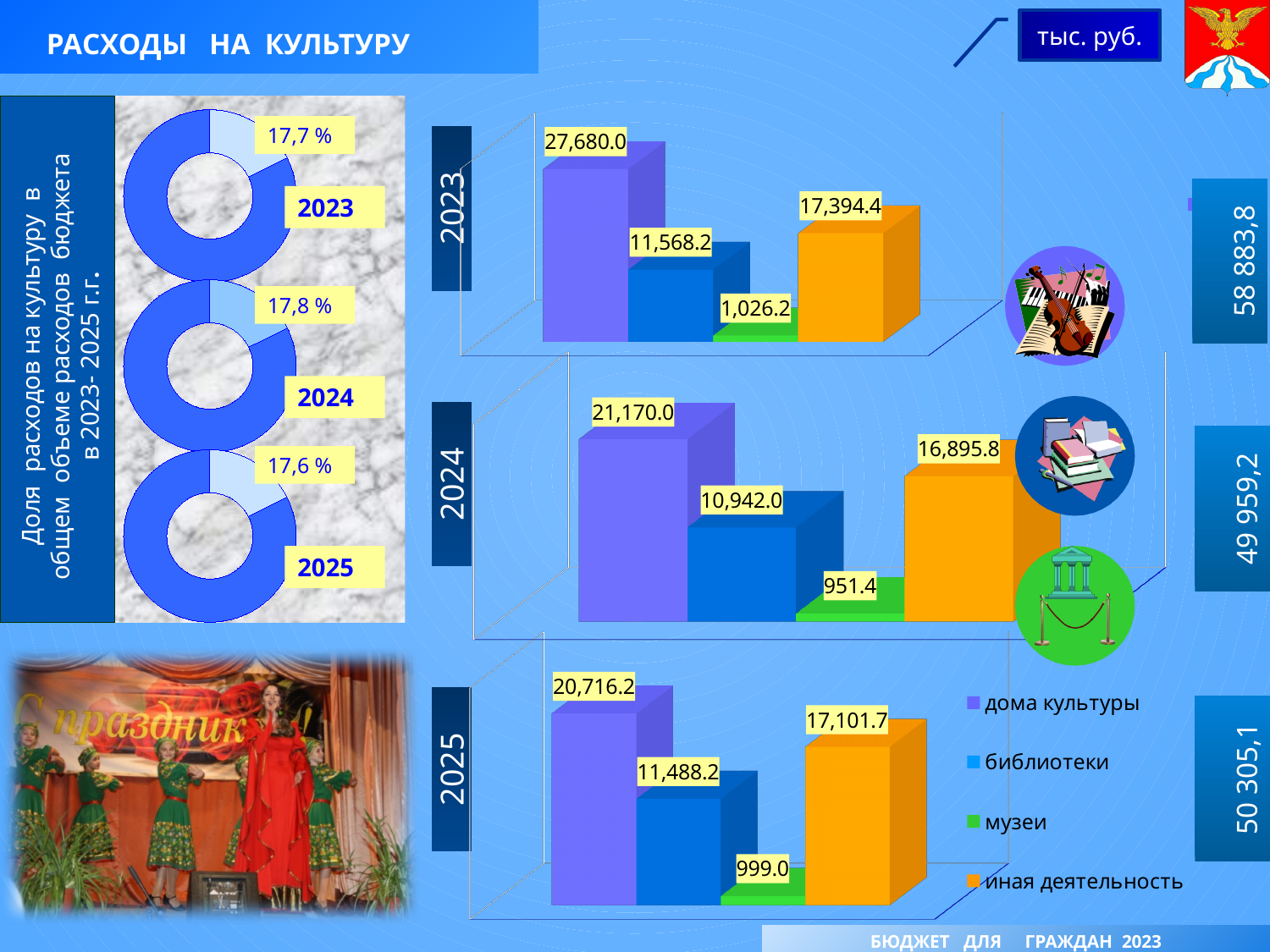
In the 2024 bar chart, which is larger: библиотеки or иная деятельность? иная деятельность In the 2024 bar chart, what is the value for библиотеки? 10,942.0 In the 2023 bar chart, what is the difference between дома культуры and иная деятельность? 10,285.6 In the 2023 bar chart, what is the value for дома культуры? 27,680.0 In the 2024 bar chart, what is the value for иная деятельность? 16,895.8 What type of chart is used to show the 2023, 2024 and 2025 expenditure breakdowns? bar chart In the 2025 bar chart, which category has the highest value? дома культуры In the 2025 bar chart, what is the value for музеи? 999.0 Which colour represents музеи in the bar charts? green In the 2023 bar chart, which category has the lowest value? музеи How many categories does the legend of the bar charts list? 4 In the donut chart for 2024, what share of total budget expenditure goes to culture? 17,8 %